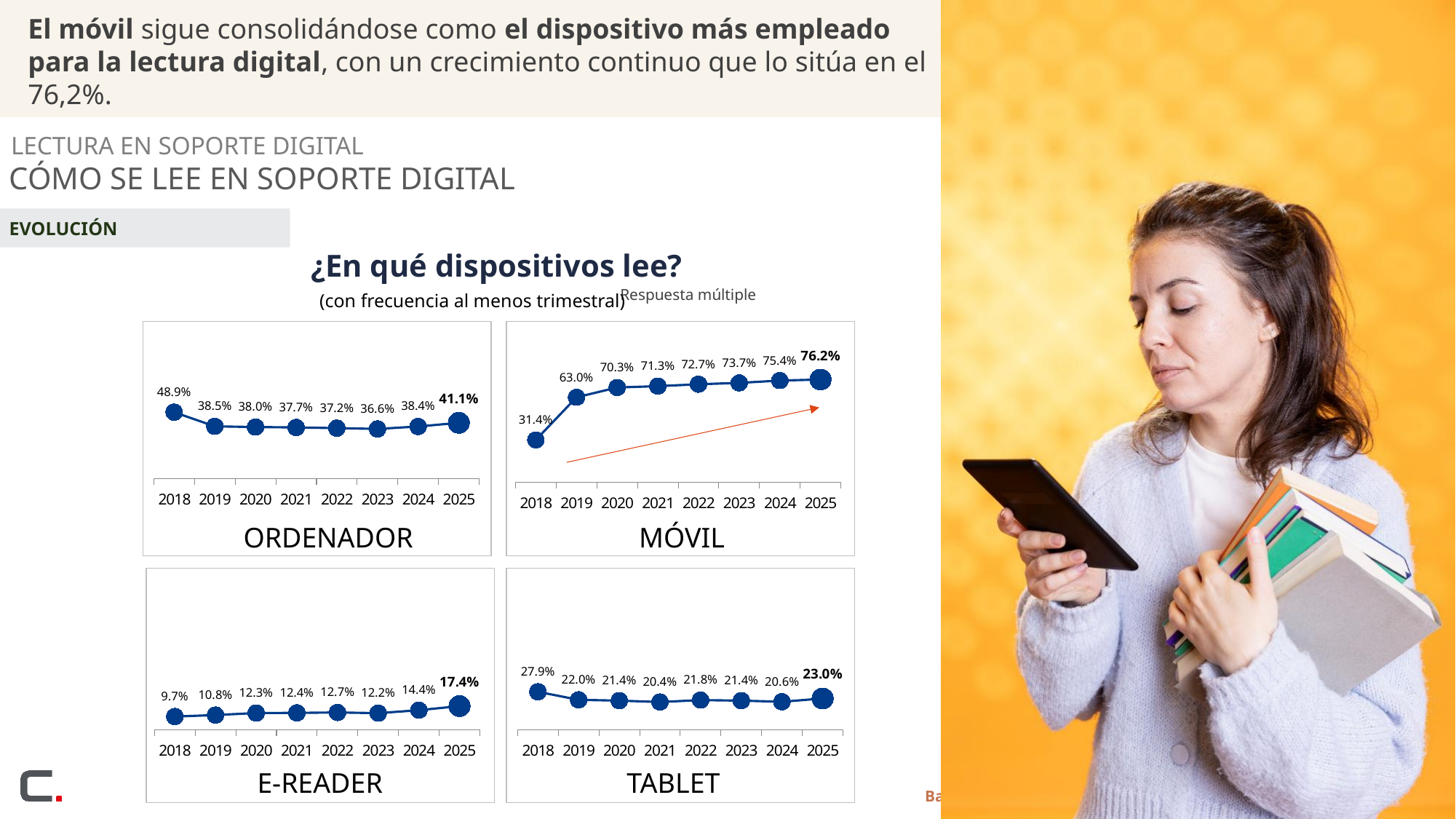
In the MÓVIL chart, what is the value for 2025? 76.2% How many years are plotted in the E-READER chart? 8 In the E-READER chart, which year has the highest value? 2025 In the ORDENADOR chart, which year has the highest value? 2018 In the ORDENADOR chart, which is larger, the value for 2024 or the value for 2025? 2025 In the MÓVIL chart, which year has the lowest value? 2018 In the MÓVIL chart, what is the difference between the 2025 value and the 2018 value? 44.8% In the E-READER chart, what is the value for 2024? 14.4% In the TABLET chart, what is the difference between the 2018 value and the 2025 value? 4.9% In the ORDENADOR chart, what is the value for 2018? 48.9% What kind of chart is the MÓVIL chart? Line chart In the TABLET chart, what is the value for 2021? 20.4%